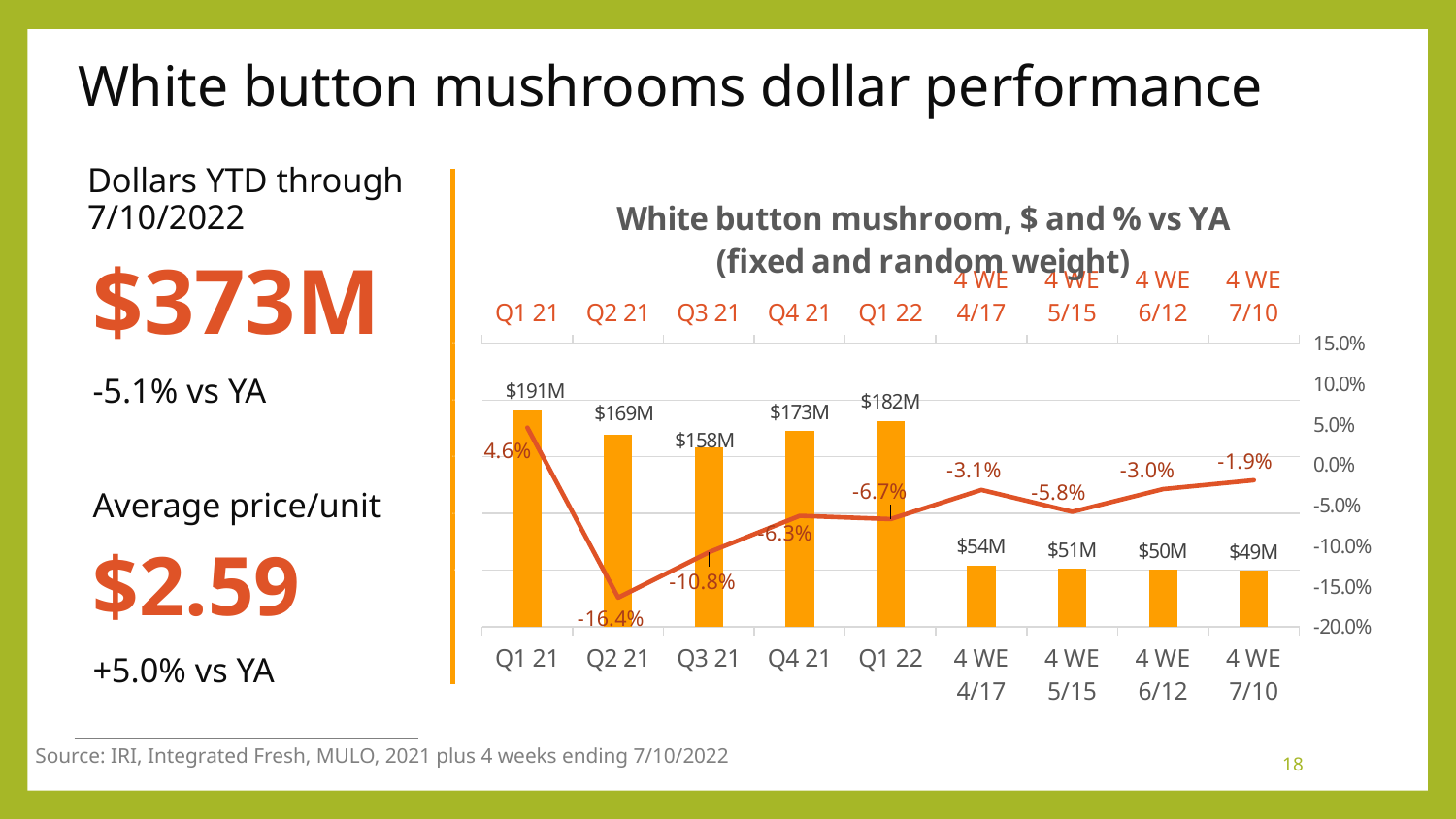
What is the % vs YA value for the 4 WE 5/15 period? -5.8% What kind of chart is this? Combination bar and line chart Which period has the highest dollar value? Q1 21 What is the % vs YA value for Q2 21? -16.4% Which is larger, the dollar value for Q2 21 or Q3 21? Q2 21 What is the difference in dollars between Q1 22 and Q4 21? $9M What is the title of the chart? White button mushroom, $ and % vs YA (fixed and random weight) How many periods are shown on the x axis? 9 What is the dollar value for the 4 WE 7/10 period? $49M Which period has the lowest % vs YA value? Q2 21 Do the % vs YA values rise or fall from Q2 21 to Q4 21? Rise What is the dollar value for Q1 21? $191M